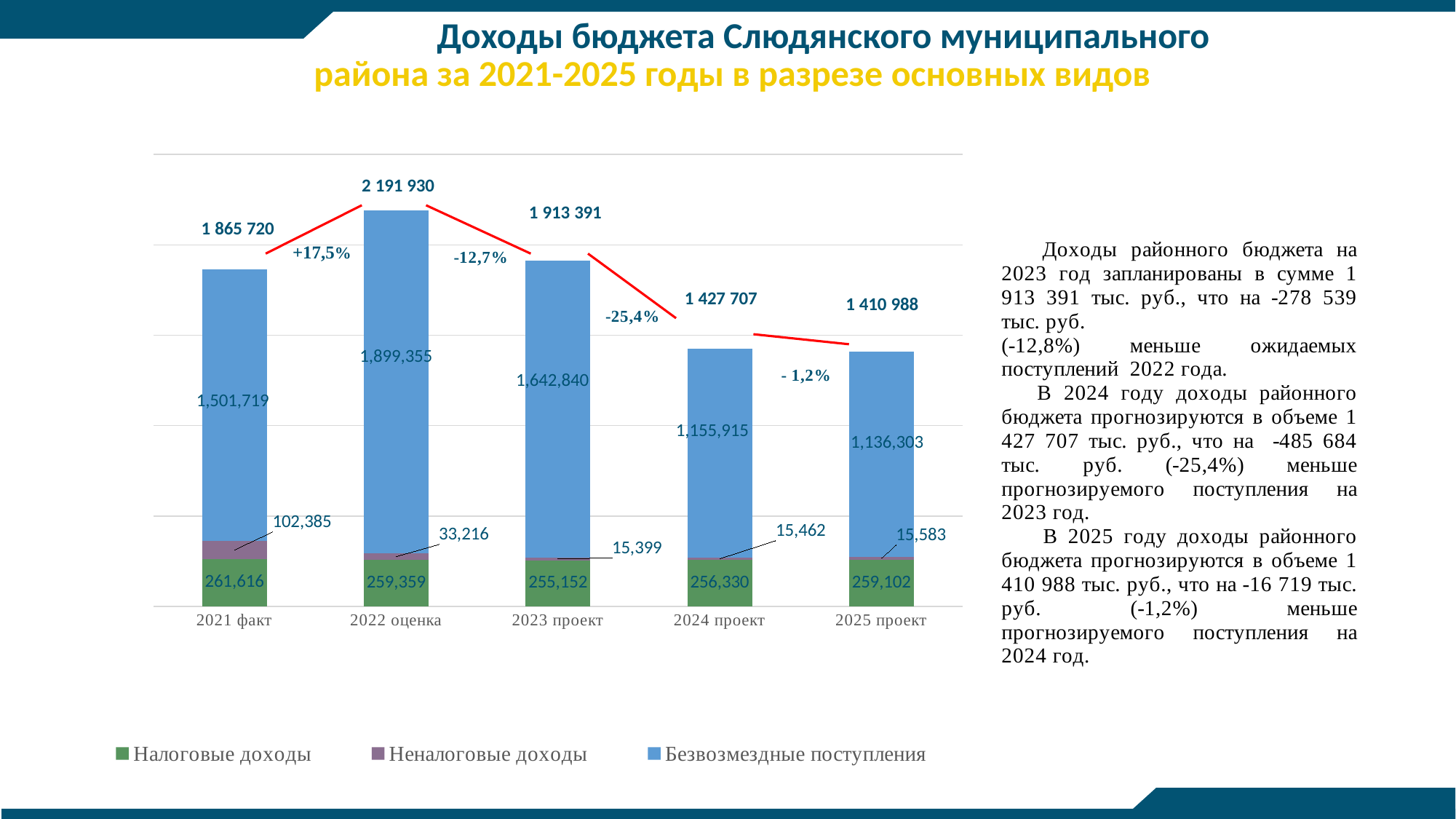
Which category has the highest total bar? 2022 оценка How many categories are shown on the x axis of the chart? 5 What is the difference between the Безвозмездные поступления values for 2023 проект and 2024 проект? 486,925 What is the total of the stacked bar for 2024 проект? 1 427 707 What type of chart is shown on the slide? Stacked bar chart Which category has the lowest value for Безвозмездные поступления? 2025 проект What is the value of Налоговые доходы for 2023 проект? 255,152 What is the value of Неналоговые доходы for 2021 факт? 102,385 What percentage change is labelled between 2021 факт and 2022 оценка? +17,5% What is the value of Безвозмездные поступления for 2022 оценка? 1,899,355 How many series does the chart legend list? 3 Which is larger: Неналоговые доходы for 2022 оценка or for 2025 проект? 2022 оценка